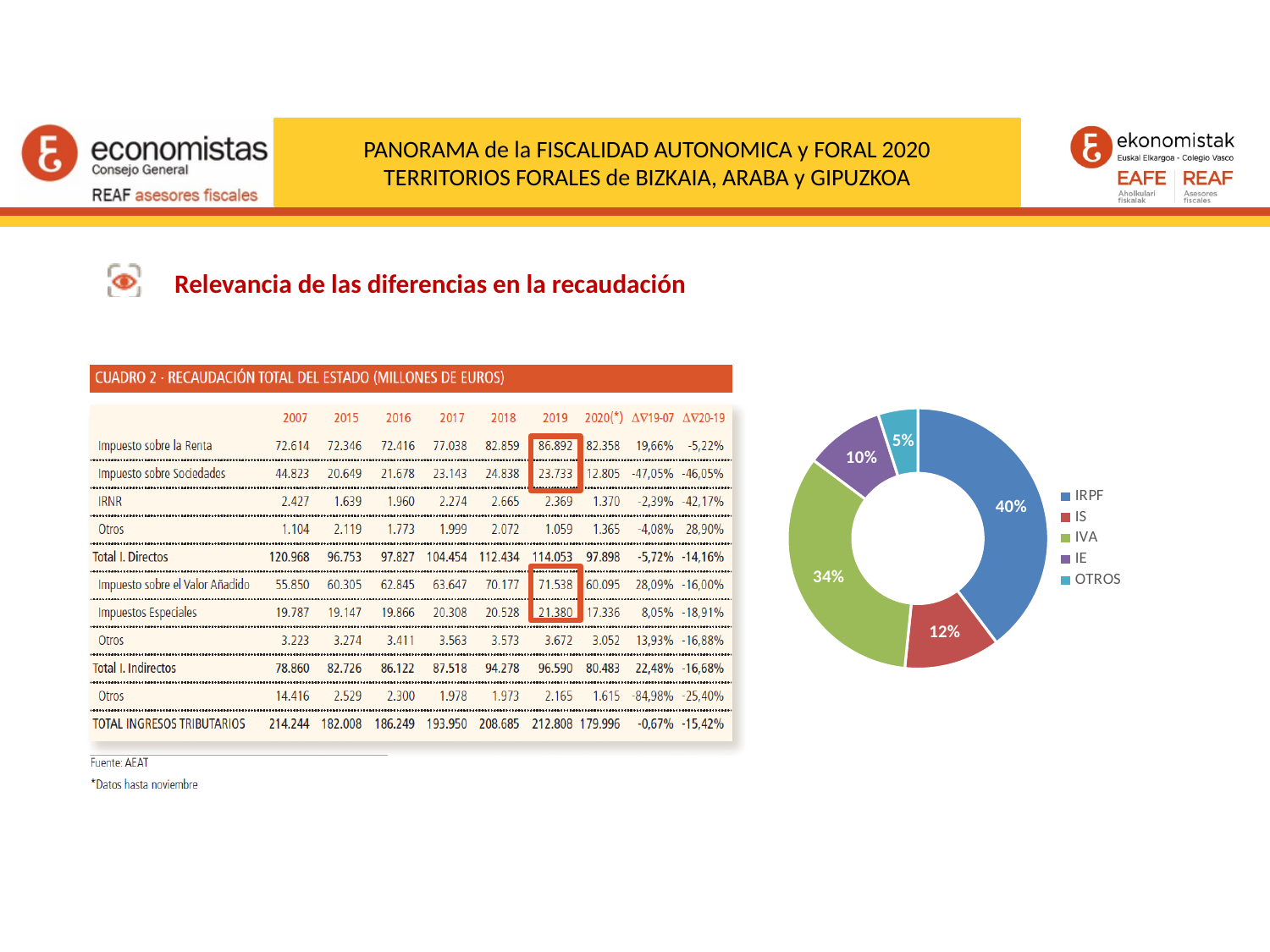
In the doughnut chart, what share does IVA have? 34% How many categories does the legend of the doughnut chart list? 5 In the doughnut chart, what share does IRPF have? 40% Which category has the largest share in the doughnut chart? IRPF In the doughnut chart, which is larger, the share of IVA or the share of IS? IVA In the doughnut chart, what is the difference in percentage points between the IRPF share and the IVA share? 6 percentage points In the doughnut chart, what share does IS have? 12% What colour is the IRPF segment in the doughnut chart? blue What kind of chart is shown on the right of the slide? doughnut chart In the doughnut chart, what share does IE have? 10% Which category has the smallest share in the doughnut chart? OTROS In the doughnut chart, what share does OTROS have? 5%